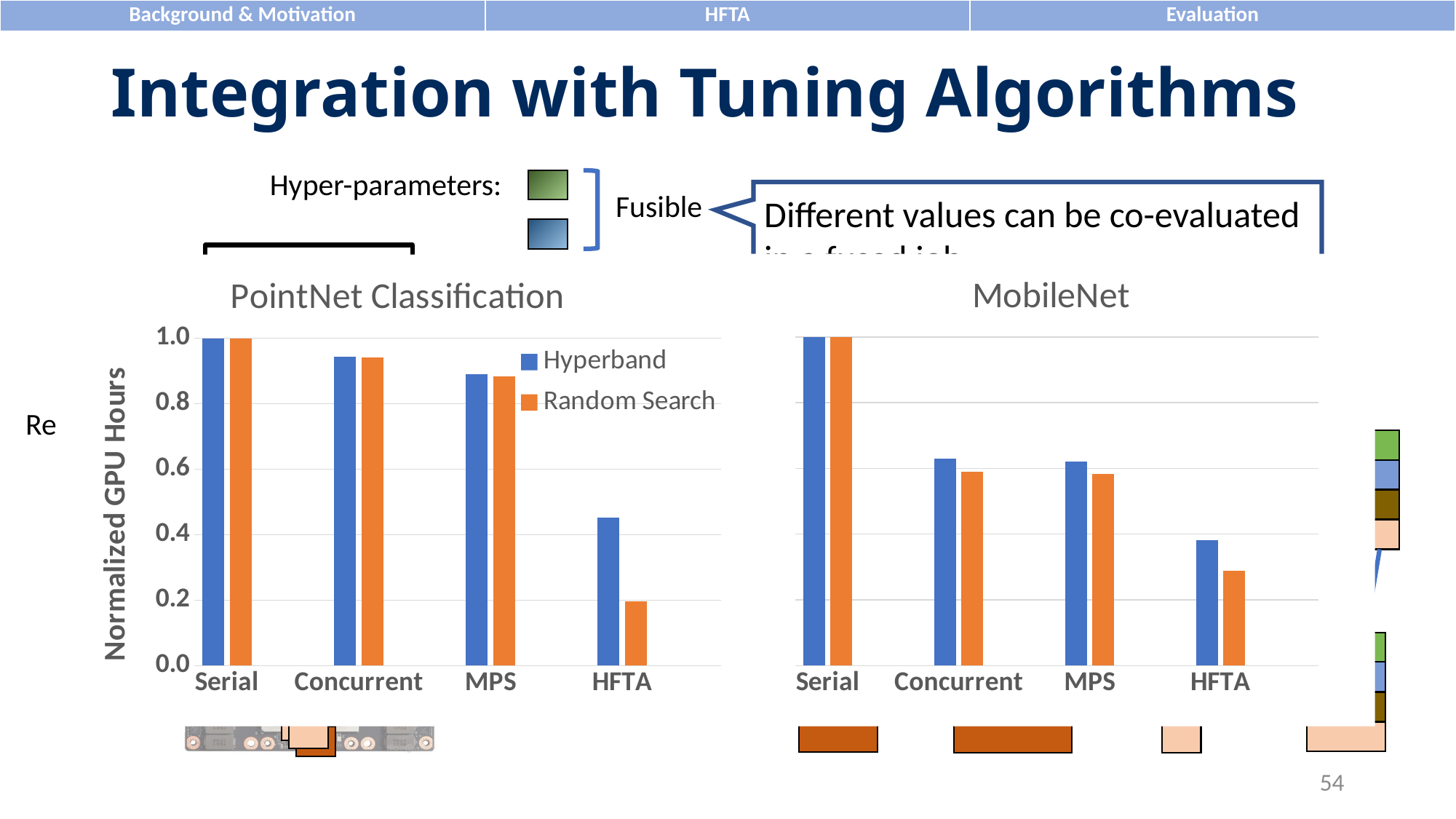
On the PointNet Classification chart, which category has the lowest Random Search value? HFTA On the MobileNet chart, is the Random Search value for HFTA greater or less than 0.4? less On the MobileNet chart, is the Hyperband value for Concurrent greater or less than 0.8? less How many categories are shown on the x axis of the MobileNet chart? 4 What kind of chart is the MobileNet chart? Bar chart On the PointNet Classification chart, which is larger for HFTA: Hyperband or Random Search? Hyperband On the PointNet Classification chart, what is the Normalized GPU Hours value for Hyperband under Serial? 1.0 How many series does the legend on the PointNet Classification chart list? 2 On the PointNet Classification chart, is the Hyperband value for HFTA greater or less than 0.4? greater On the MobileNet chart, which category has the lowest Hyperband value? HFTA On the MobileNet chart, what is the Normalized GPU Hours value for Random Search under Serial? 1.0